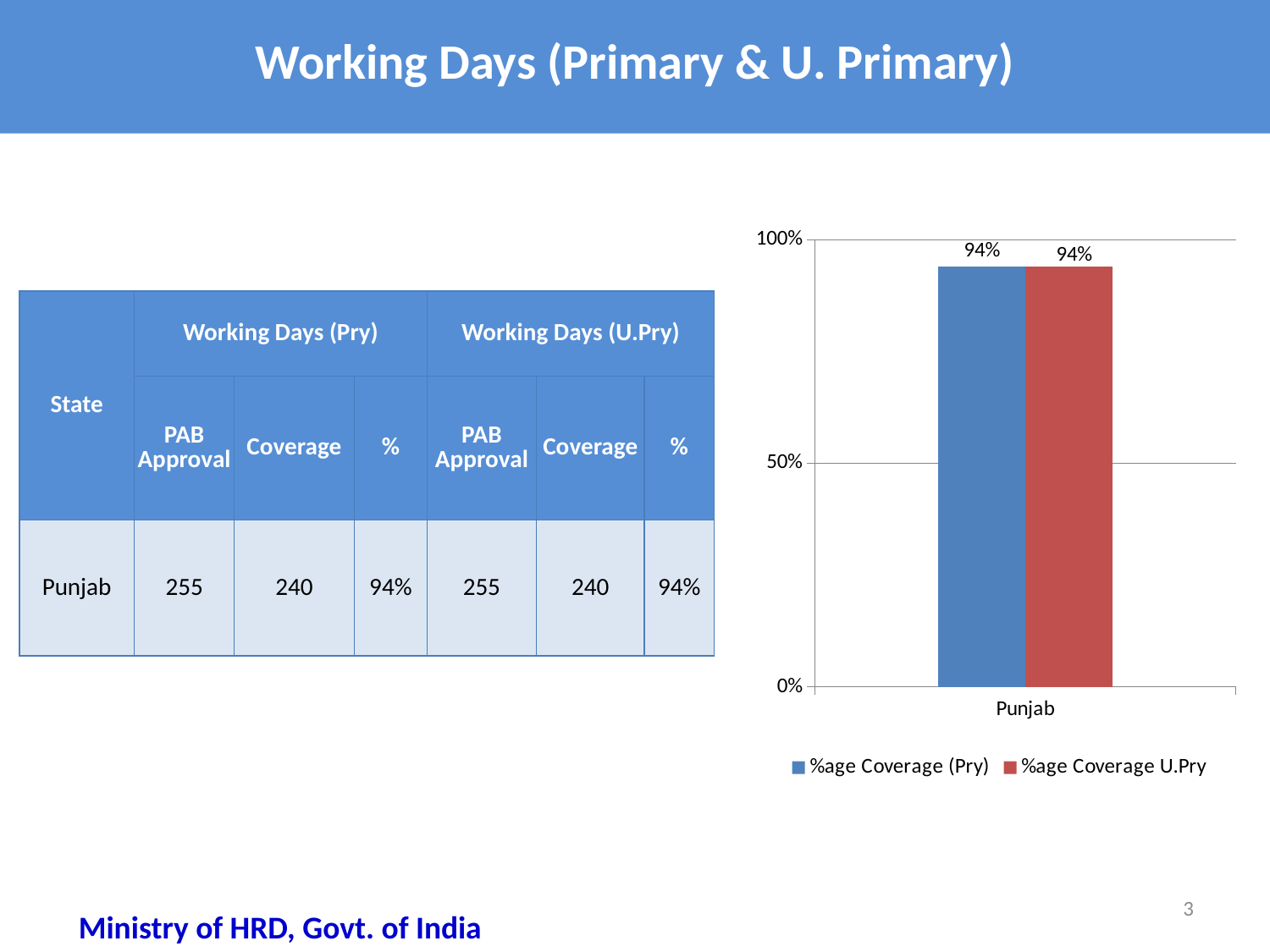
Is the value for %age Coverage U.Pry for Punjab greater or less than 100%? less Which category label appears on the x axis of the chart? Punjab What is the difference between %age Coverage (Pry) and %age Coverage U.Pry for Punjab? 0% What kind of chart is shown on the slide? bar chart What colour is the %age Coverage U.Pry series in the chart? red How many series does the chart legend list? 2 What is the value of %age Coverage (Pry) for Punjab in the chart? 94% What is the value of %age Coverage U.Pry for Punjab in the chart? 94% Is the value for %age Coverage (Pry) for Punjab greater or less than 50%? greater How many categories are shown on the x axis of the chart? 1